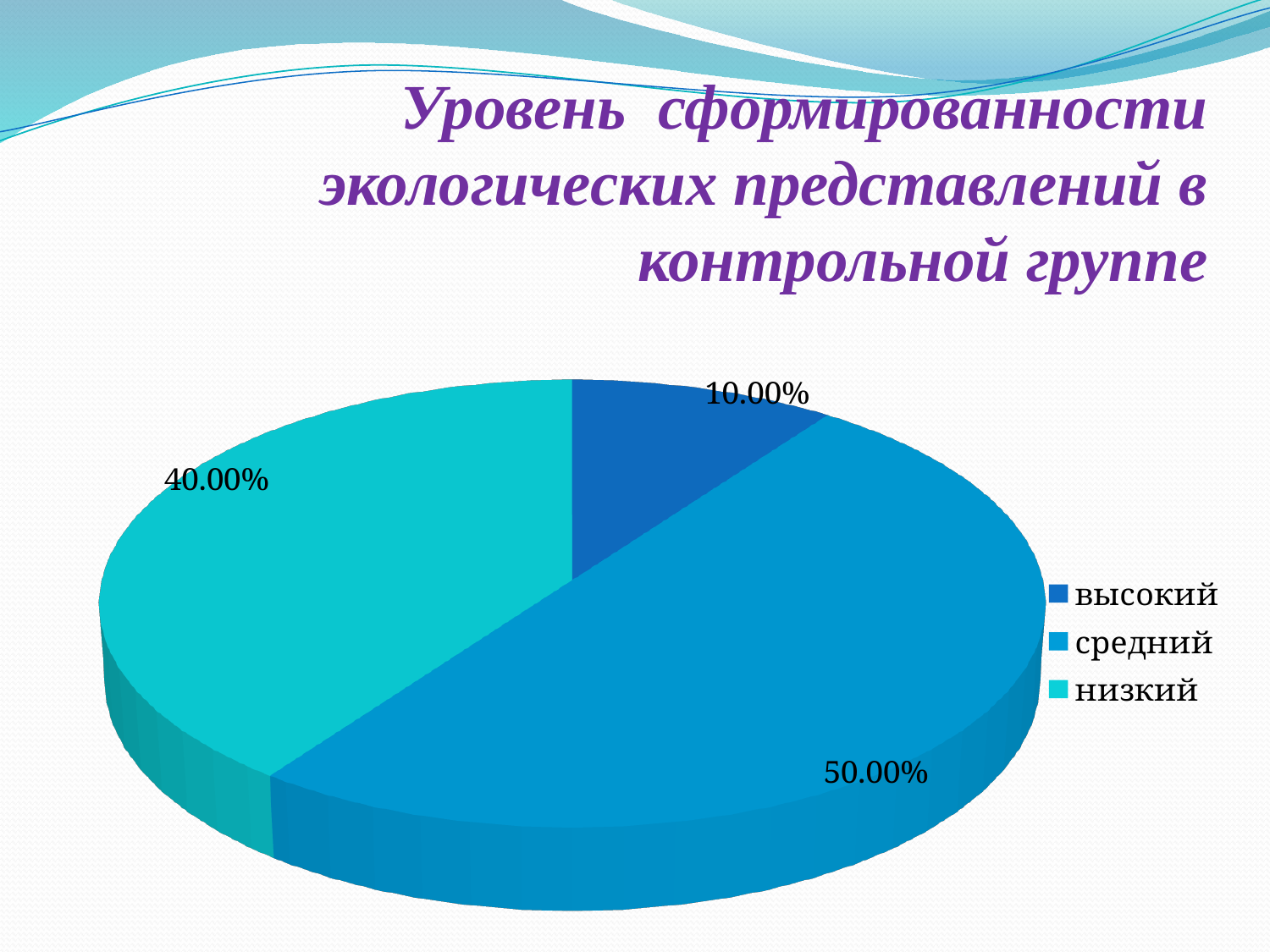
How many entries does the legend list? 3 What is the value for the "средний" slice? 50.00% Which category has the largest share of the pie? средний What is the value for the "низкий" slice? 40.00% What is the value for the "высокий" slice? 10.00% Which is larger, the "низкий" slice or the "высокий" slice? низкий What kind of chart is shown on the slide? pie chart How many slices does the pie chart have? 3 Which category has the smallest share of the pie? высокий What is the title of the slide containing the chart? Уровень сформированности экологических представлений в контрольной группе What is the difference between the "низкий" and "высокий" shares? 30.00% What is the difference between the "средний" and "низкий" shares? 10.00%